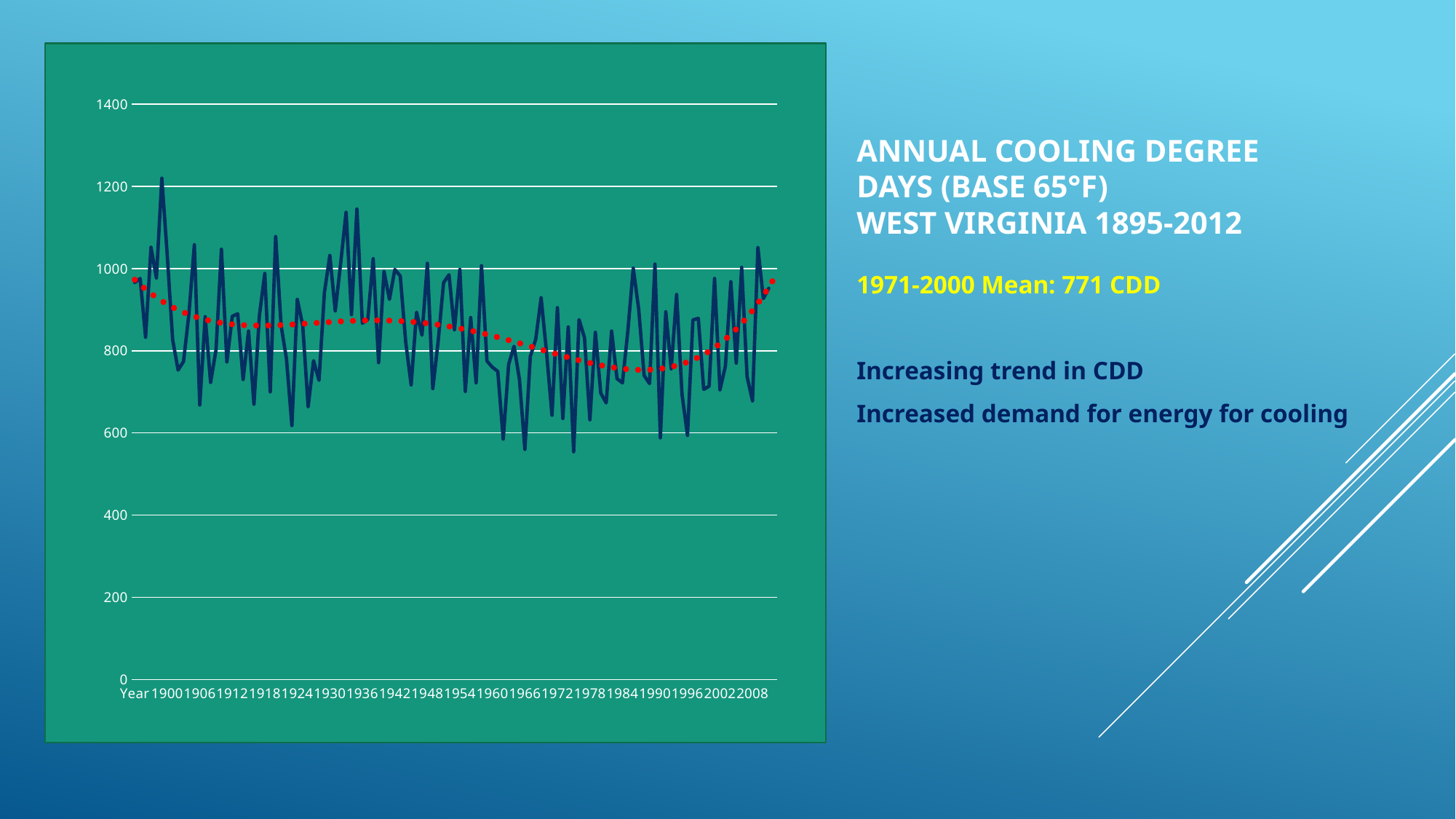
Is the highest peak of the dark line greater or less than 1000? greater What is the first year tick shown after 'Year' on the horizontal axis? 1900 According to the slide text, what is the 1971-2000 mean in CDD? 771 CDD What is the last year tick shown on the horizontal axis? 2008 Does the red dotted trend line rise or fall between 1900 and 1960? fall Is the lowest point of the dark line greater or less than 600? less What kind of chart is shown on the slide? line chart Is the red dotted trend line around 1978 greater or less than 800? less What is the highest value shown on the vertical axis of the chart? 1400 Does the red dotted trend line rise or fall between 1984 and 2008? rise What is the label at the start of the horizontal axis of the chart? Year